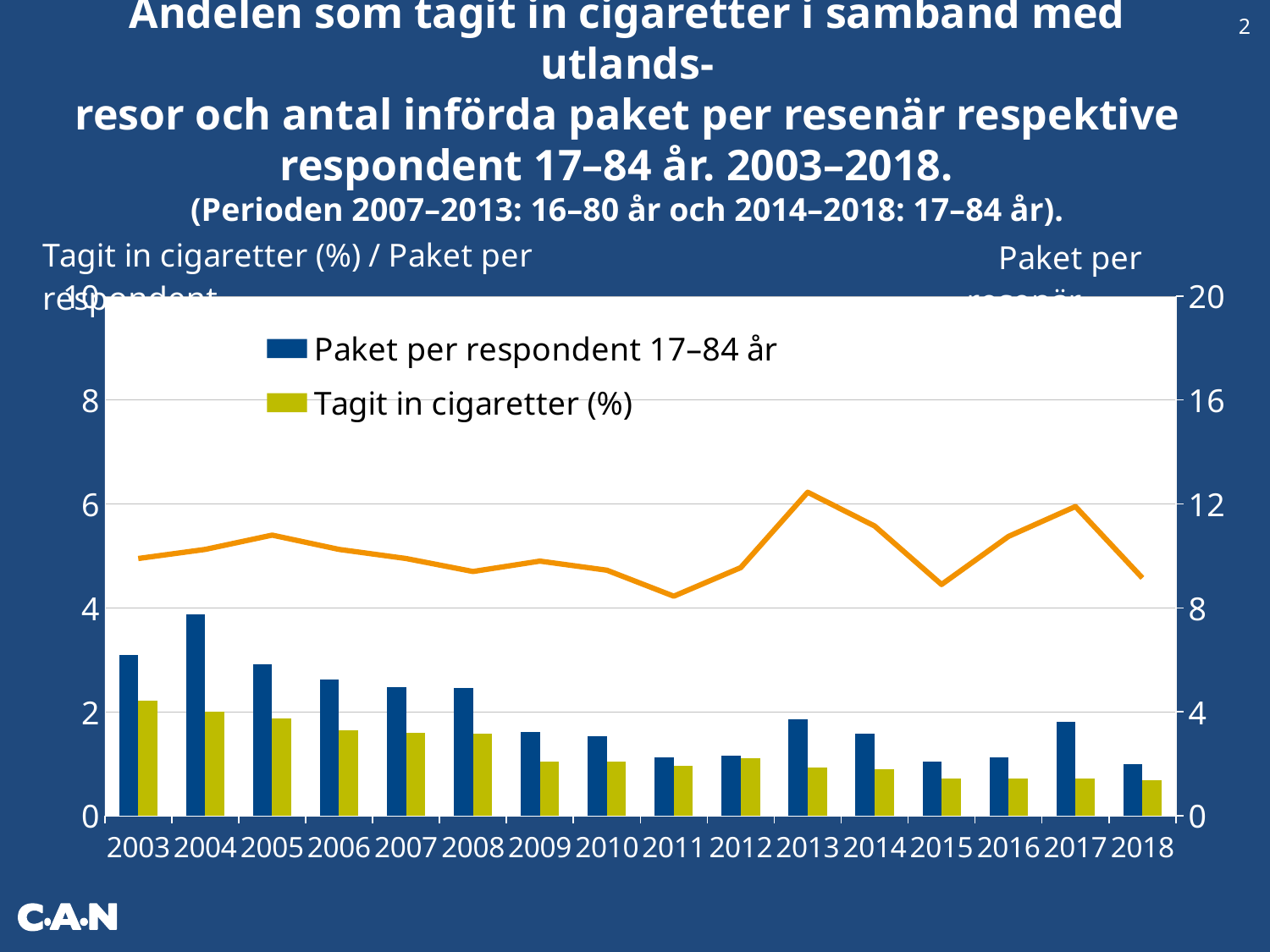
Is the 'Paket per respondent 17–84 år' value for 2004 greater or less than 2? greater How many series does the chart legend list? 2 In which year does the orange 'Paket per resenär' line reach its highest point? 2013 Do the 'Paket per respondent 17–84 år' bars generally rise or fall from 2003 to 2018? fall In which year is the bar for 'Tagit in cigaretter (%)' highest? 2003 In which year is the bar for 'Paket per respondent 17–84 år' highest? 2004 How many years are shown on the x axis of the chart? 16 What colour is used for the 'Tagit in cigaretter (%)' series in the legend? Yellow-green Is the 'Tagit in cigaretter (%)' value for 2018 greater or less than 1? less On the right axis, is the 'Paket per resenär' line value for 2011 greater or less than 10? less Which is larger, the 'Paket per respondent 17–84 år' bar for 2004 or for 2005? 2004 What kind of chart is shown on the slide? Bar chart combined with a line